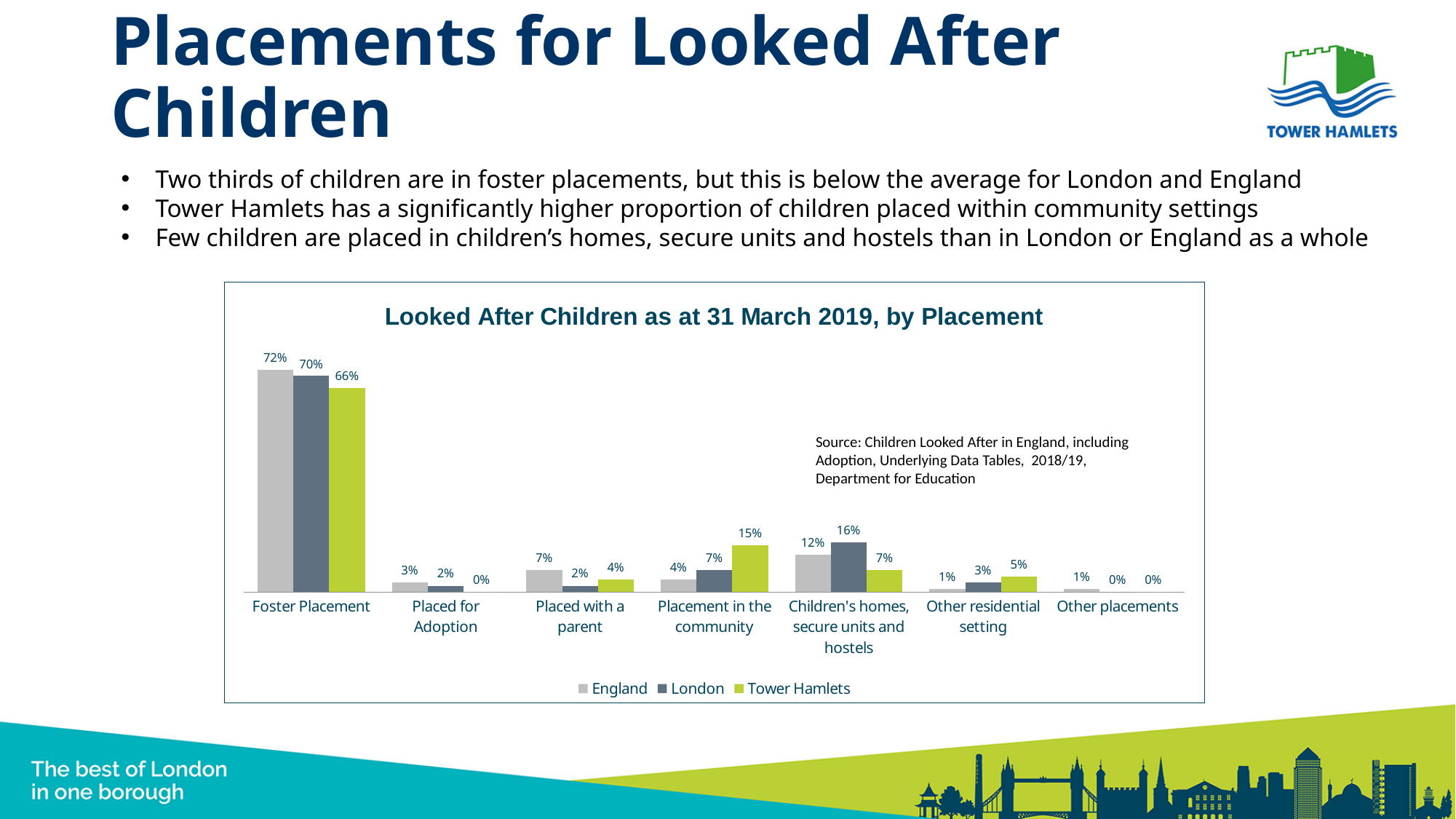
What is the value for England in the Placed with a parent category? 7% What kind of chart is shown on the slide? Bar chart What is the value for Tower Hamlets in the Placement in the community category? 15% How many series does the legend list? 3 Which category has the highest value for England? Foster Placement What is the value for Tower Hamlets in the Foster Placement category? 66% What is the value for London in the Children's homes, secure units and hostels category? 16% What is the difference between the Tower Hamlets and England values for Placement in the community? 11% What is the difference between the England and Tower Hamlets values for Foster Placement? 6% How many placement categories are shown on the x axis? 7 Which series has the lowest value in the Foster Placement category? Tower Hamlets Which is larger in the Other residential setting category: the London value or the Tower Hamlets value? Tower Hamlets